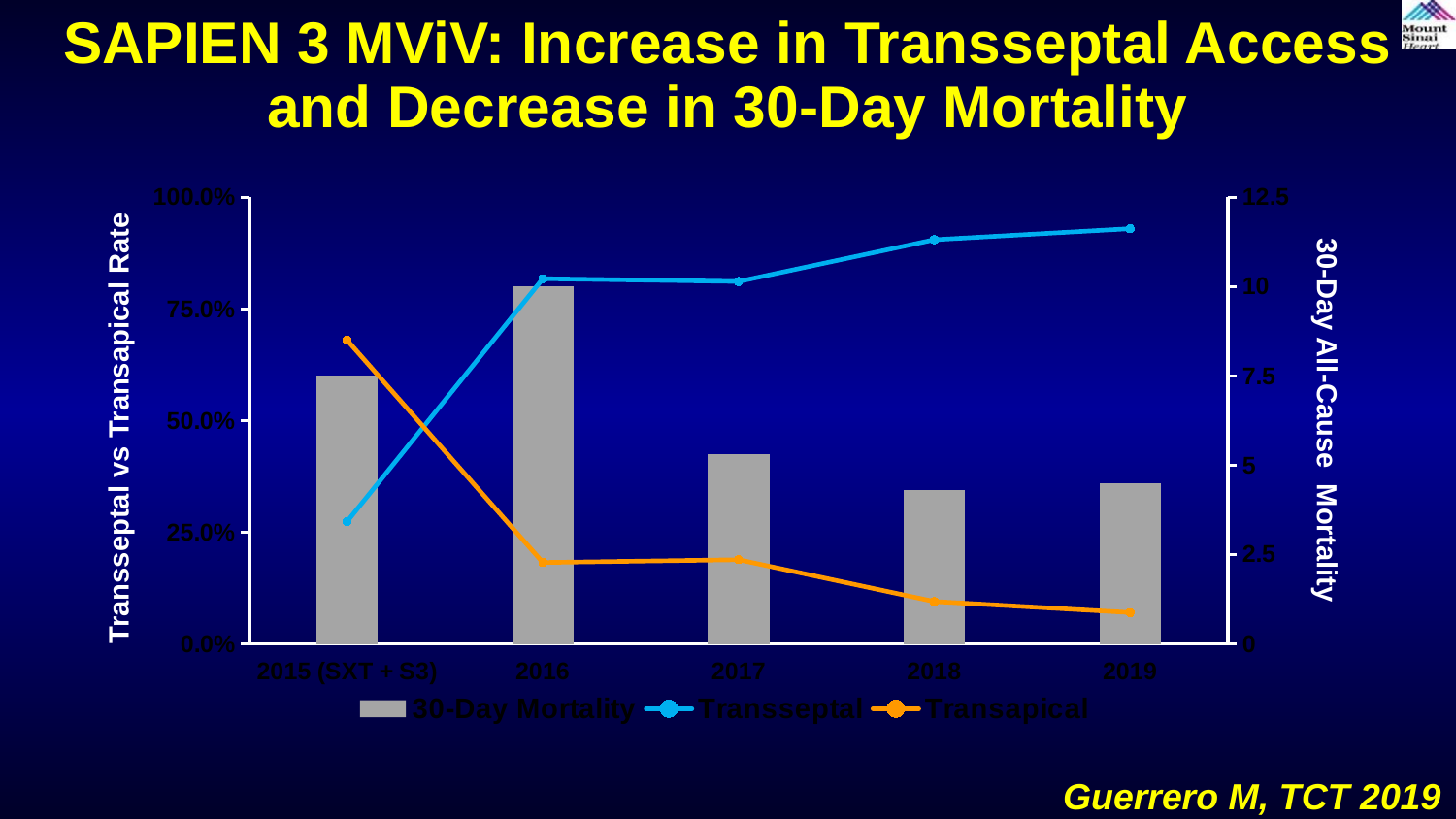
Which year has the lowest Transseptal rate? 2015 (SXT + S3) How many year categories are shown on the x axis? 5 Which year has the highest Transapical rate? 2015 (SXT + S3) Is the 30-Day Mortality value for 2017 greater or less than 7.5? less Is the Transseptal rate in 2015 (SXT + S3) greater or less than 50.0%? less Is the Transseptal rate in 2019 greater or less than 75.0%? greater In 2019, which is larger, the Transseptal rate or the Transapical rate? Transseptal Which year has the highest 30-Day Mortality bar? 2016 How many series does the legend list? 3 What kind of chart is shown on the slide? A combined bar and line chart Does the Transapical rate rise or fall from 2015 to 2019? Fall